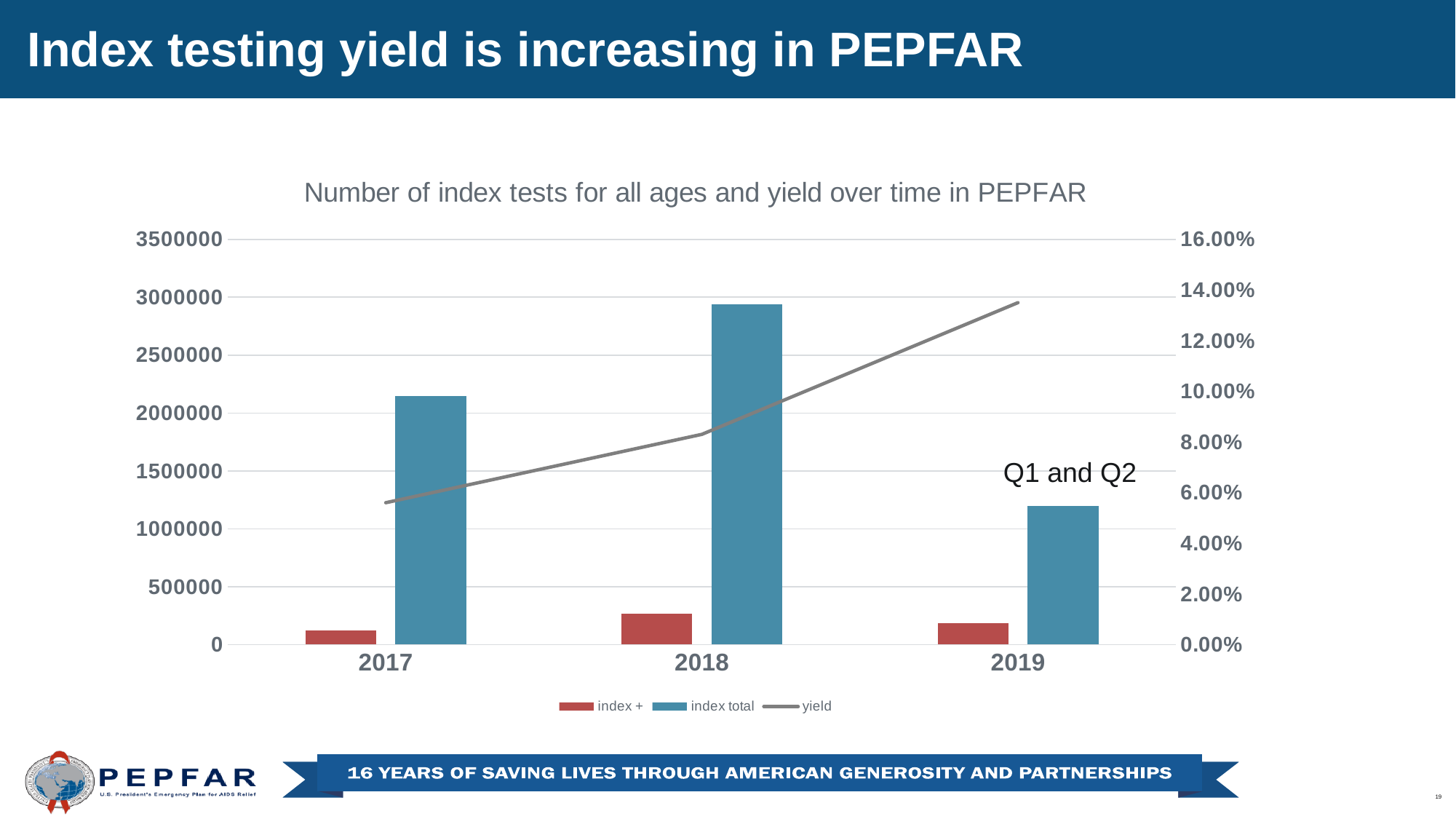
Does the yield line rise or fall from 2017 to 2019? rises How many series does the chart legend list? 3 Is the index total for 2019 greater or less than 1500000? less What is the title of the chart? Number of index tests for all ages and yield over time in PEPFAR Which year has the highest index + value? 2018 Is the yield for 2019 greater or less than 12.00%? greater Which series is plotted as a line rather than bars? yield Which year has the highest index total? 2018 Which is larger, the index total for 2017 or the index total for 2019? 2017 How many years are shown on the x axis of the chart? 3 Is the index total for 2018 greater or less than 2500000? greater Which year has the lowest index total? 2019